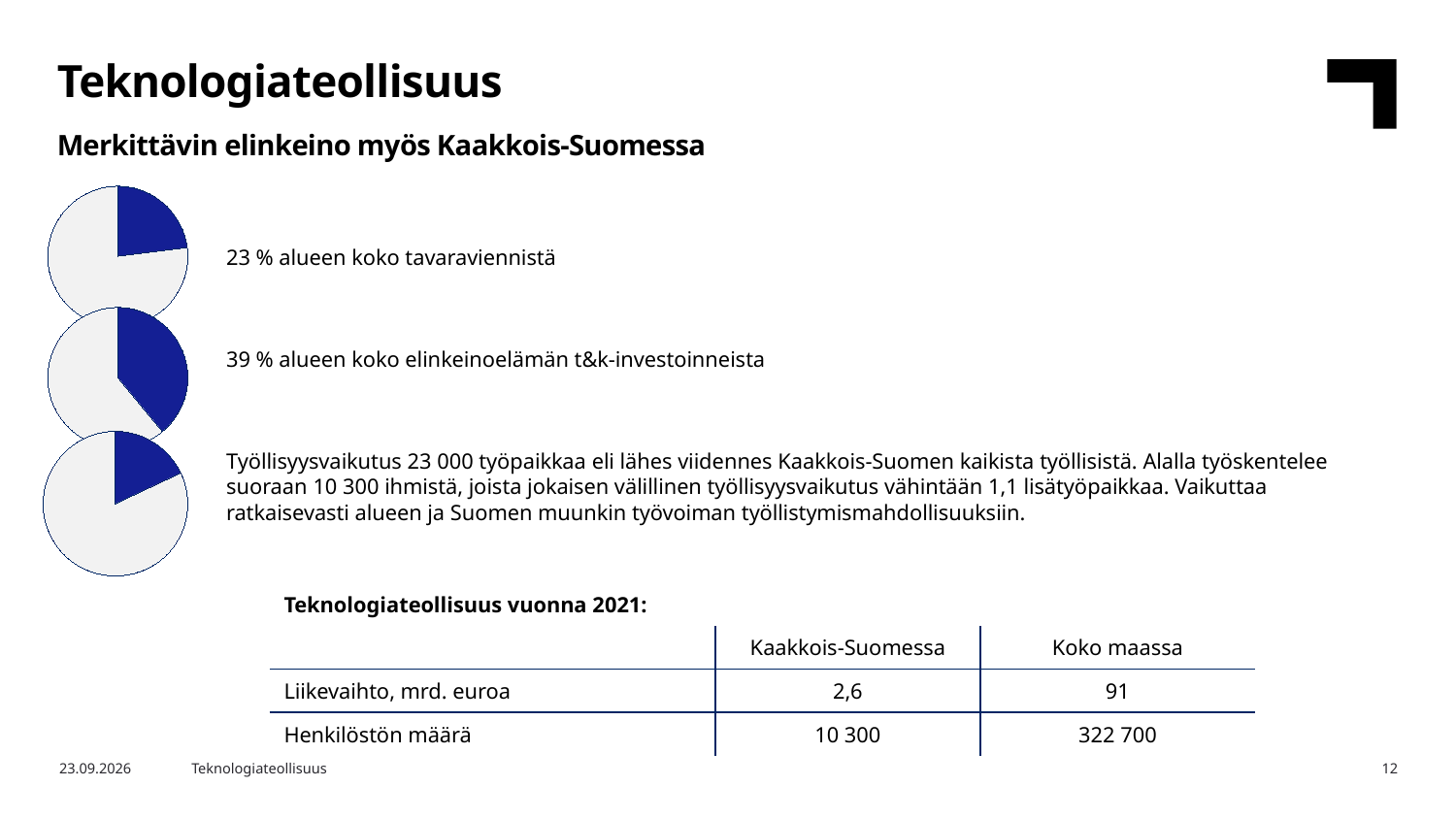
In the top pie chart, what share of the region's total goods exports does the highlighted slice represent? 23 % What is the difference in percentage points between the share shown for the middle pie chart and the share shown for the top pie chart? 16 percentage points In the middle pie chart, what share of the region's business R&D investments does the highlighted slice represent? 39 % What does the top pie chart represent, according to the text next to it? 23 % alueen koko tavaraviennistä Is the highlighted slice in the middle pie chart more or less than half of the pie? Less Is the highlighted slice in the middle pie chart larger or smaller than the highlighted slice in the top pie chart? Larger What colour is used for the highlighted slice in the pie charts? Blue Which pie chart has the largest highlighted slice: the top, middle or bottom one? Middle What kind of chart is shown at the top left of the slide? Pie chart How many pie charts are shown on the slide? 3